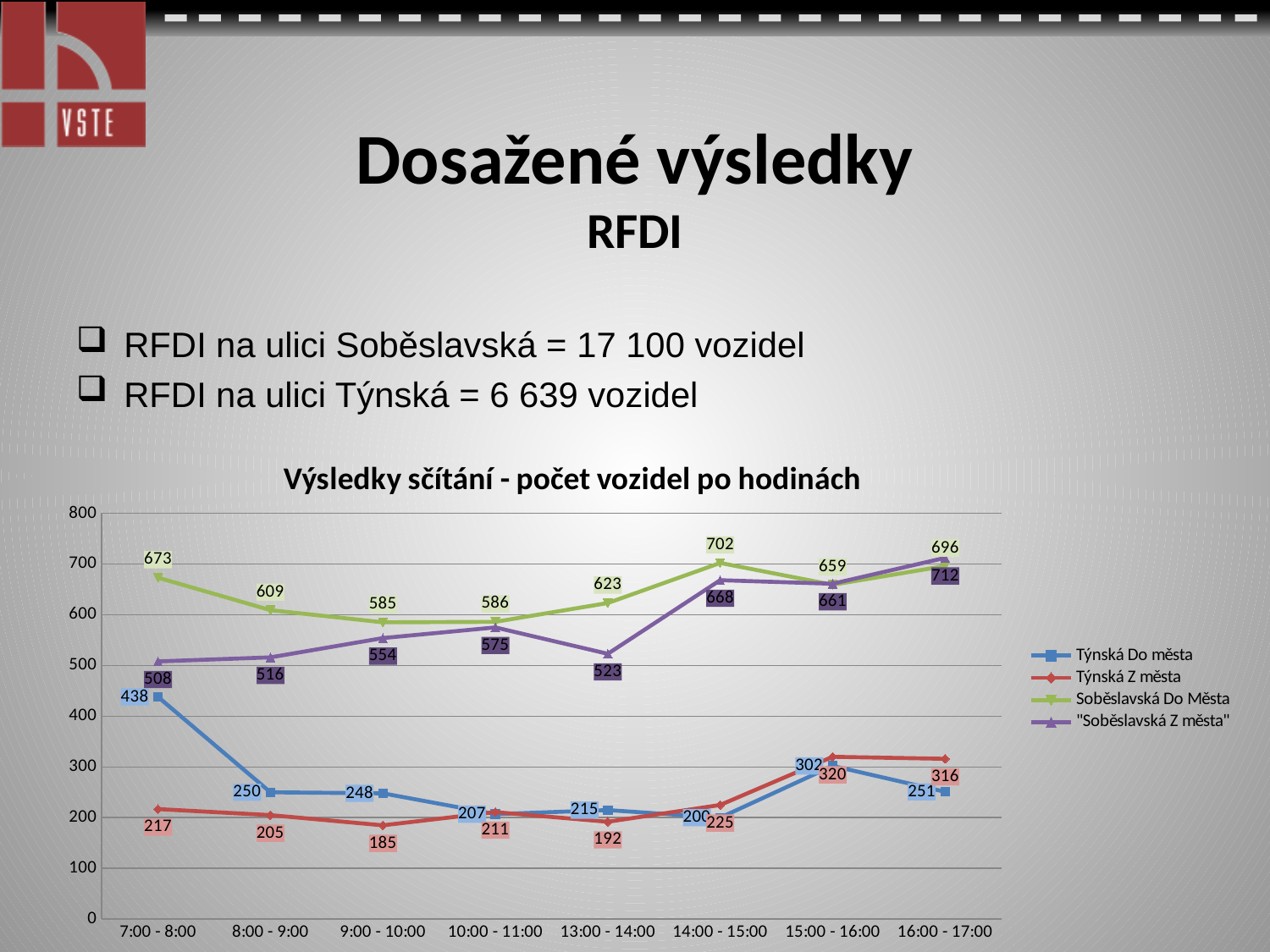
What is the value for Soběslavská Do Města in the 14:00 - 15:00 interval? 702 What is the difference between Soběslavská Do Města and Soběslavská Z města in the 7:00 - 8:00 interval? 165 Which is larger in the 15:00 - 16:00 interval, Týnská Do města or Týnská Z města? Týnská Z města What is the value for Týnská Do města in the 7:00 - 8:00 interval? 438 What is the value for Týnská Z města in the 9:00 - 10:00 interval? 185 In which time interval does Týnská Z města have its lowest value? 9:00 - 10:00 What type of chart is shown on the slide? line chart In which time interval does Soběslavská Z města reach its highest value? 16:00 - 17:00 Does the value for Týnská Do města fall or rise from 7:00 - 8:00 to 8:00 - 9:00? fall How many time intervals are shown on the x axis? 8 How many series does the legend list? 4 What is the title of the chart? Výsledky sčítání - počet vozidel po hodinách